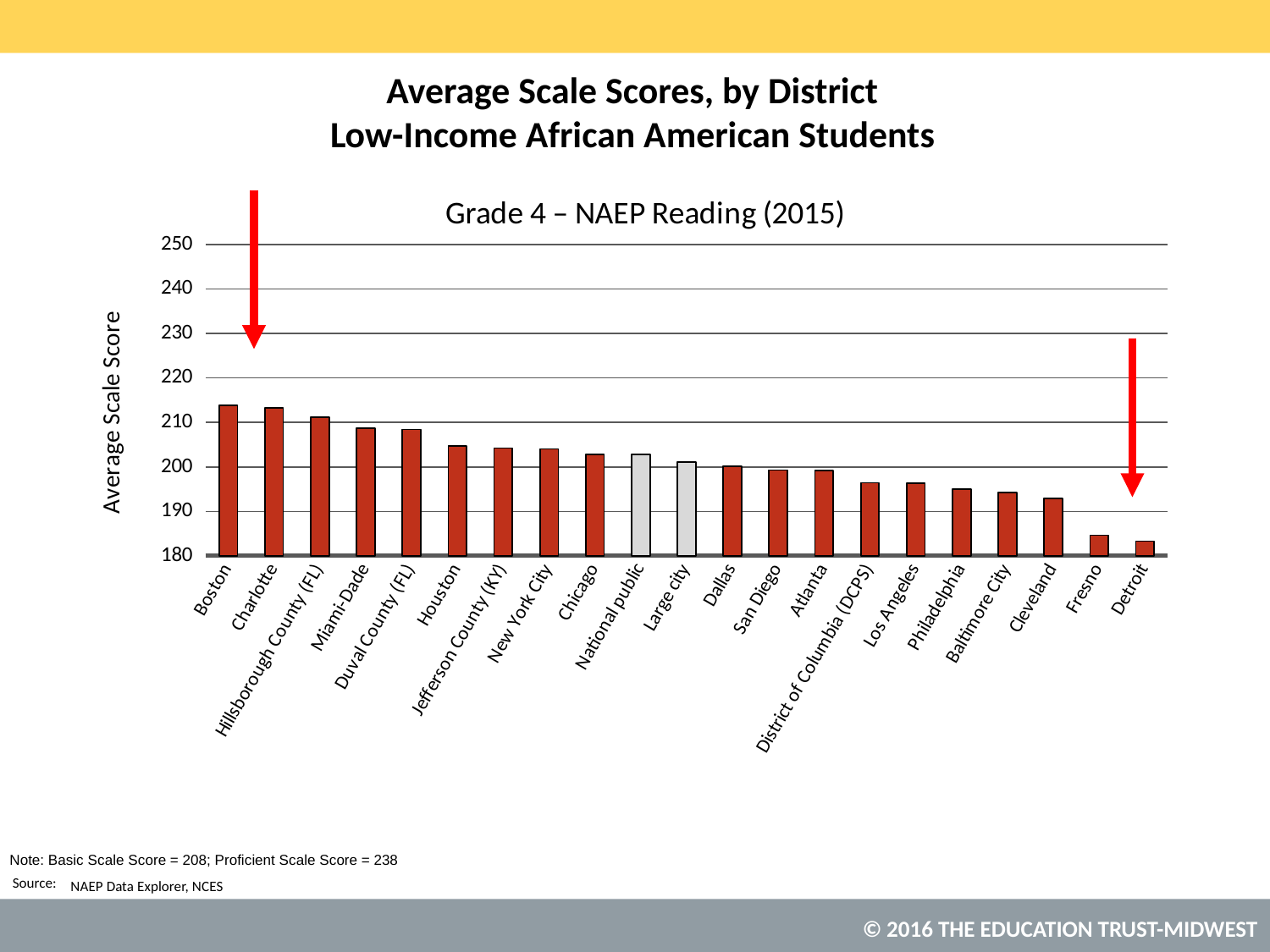
Which category has the lowest average scale score? Detroit Which is larger, the value for Boston or the value for Detroit? Boston Do the values rise or fall moving from left to right along the x axis? fall Is the value for Cleveland greater or less than 200? less Is the value for Philadelphia greater or less than 200? less Is the value for Boston greater or less than 210? greater What kind of chart is shown on the slide? bar chart How many districts or categories are plotted along the x axis? 21 What is the label on the y axis of the chart? Average Scale Score Which is larger, the value for Houston or the value for Fresno? Houston